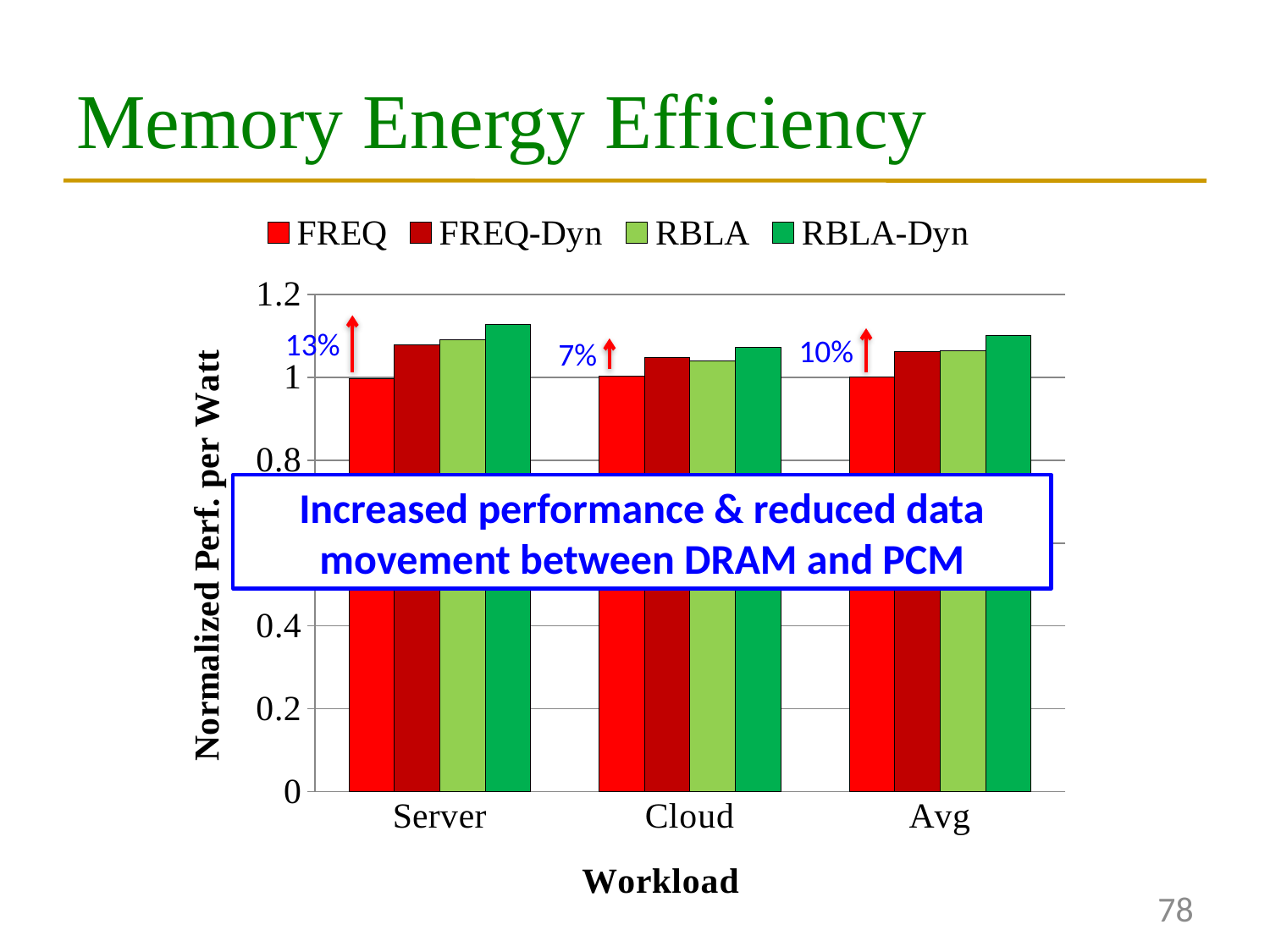
How many series does the legend list? 4 Is the value for RBLA-Dyn on the Server workload greater or less than 1? greater What percentage improvement is annotated above the Server workload group? 13% Is the value for FREQ-Dyn on the Cloud workload greater or less than 0.8? greater For the Cloud workload, which is larger: the FREQ bar or the RBLA-Dyn bar? RBLA-Dyn Which series has the highest bar for the Server workload? RBLA-Dyn Which series has the lowest bar for the Avg workload? FREQ What is the title of the y axis? Normalized Perf. per Watt How many workload categories are shown on the x axis? 3 What is the title of the x axis? Workload What kind of chart is shown on the slide? bar chart